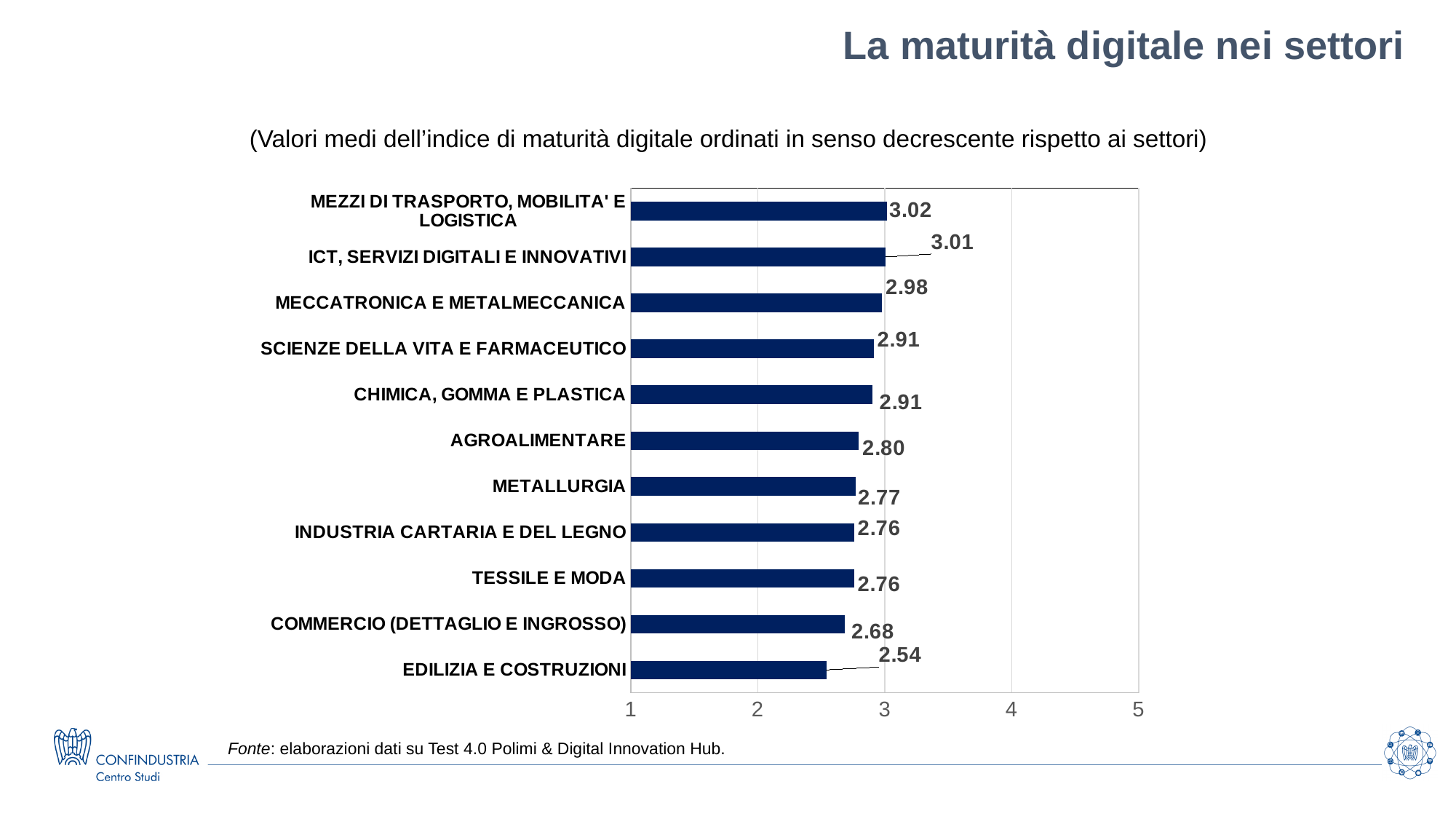
Which sector has the lowest digital maturity index value? EDILIZIA E COSTRUZIONI What is the value shown for COMMERCIO (DETTAGLIO E INGROSSO)? 2.68 What is the digital maturity index value for MEZZI DI TRASPORTO, MOBILITA' E LOGISTICA? 3.02 What is the value shown for EDILIZIA E COSTRUZIONI? 2.54 How many sectors are shown in the chart? 11 What kind of chart is shown on the slide? bar chart What is the value shown for AGROALIMENTARE? 2.80 Is the value for EDILIZIA E COSTRUZIONI greater or less than 3? less Which has a higher value, AGROALIMENTARE or COMMERCIO (DETTAGLIO E INGROSSO)? AGROALIMENTARE What is the difference between the values for MEZZI DI TRASPORTO, MOBILITA' E LOGISTICA and EDILIZIA E COSTRUZIONI? 0.48 What is the title of the slide? La maturità digitale nei settori Which sector has the highest digital maturity index value? MEZZI DI TRASPORTO, MOBILITA' E LOGISTICA